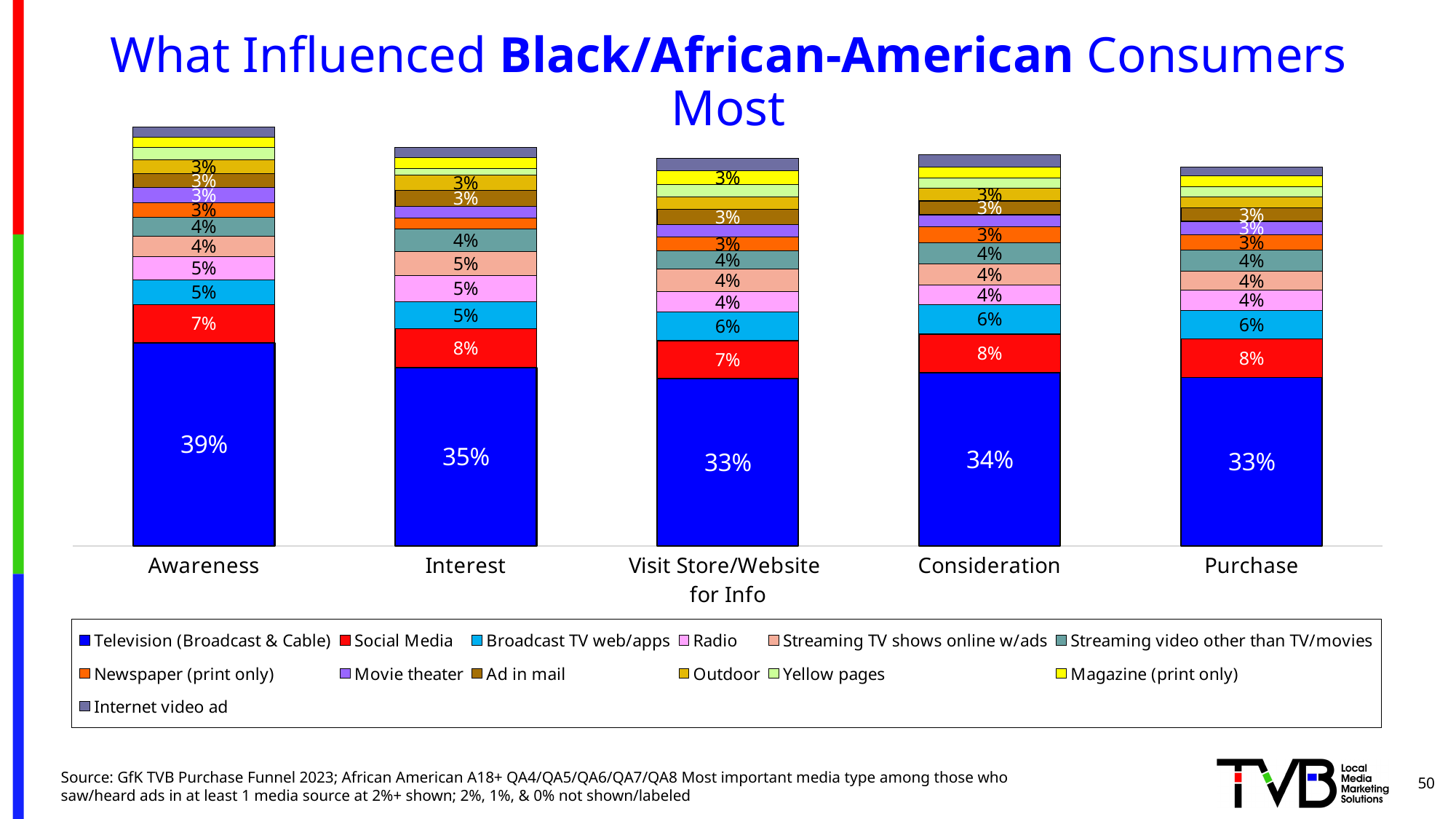
What is the value for Television (Broadcast & Cable) in the Awareness bar? 39% How many purchase-funnel stages (categories) are shown along the x axis? 5 What kind of chart is shown on the slide? Stacked bar chart In which stage is the Television (Broadcast & Cable) value highest? Awareness Which is larger: the Social Media value for Awareness or for Consideration? Consideration What is the value for Radio in the Awareness bar? 5% What is the value for Broadcast TV web/apps in the Purchase bar? 6% How many series does the legend list? 13 What is the difference between the Television (Broadcast & Cable) values for Awareness and Purchase? 6 percentage points What is the value for Streaming TV shows online w/ads in the Interest bar? 5% Which series forms the bottom (blue) segment of each stacked bar? Television (Broadcast & Cable) What is the value for Social Media in the Interest bar? 8%